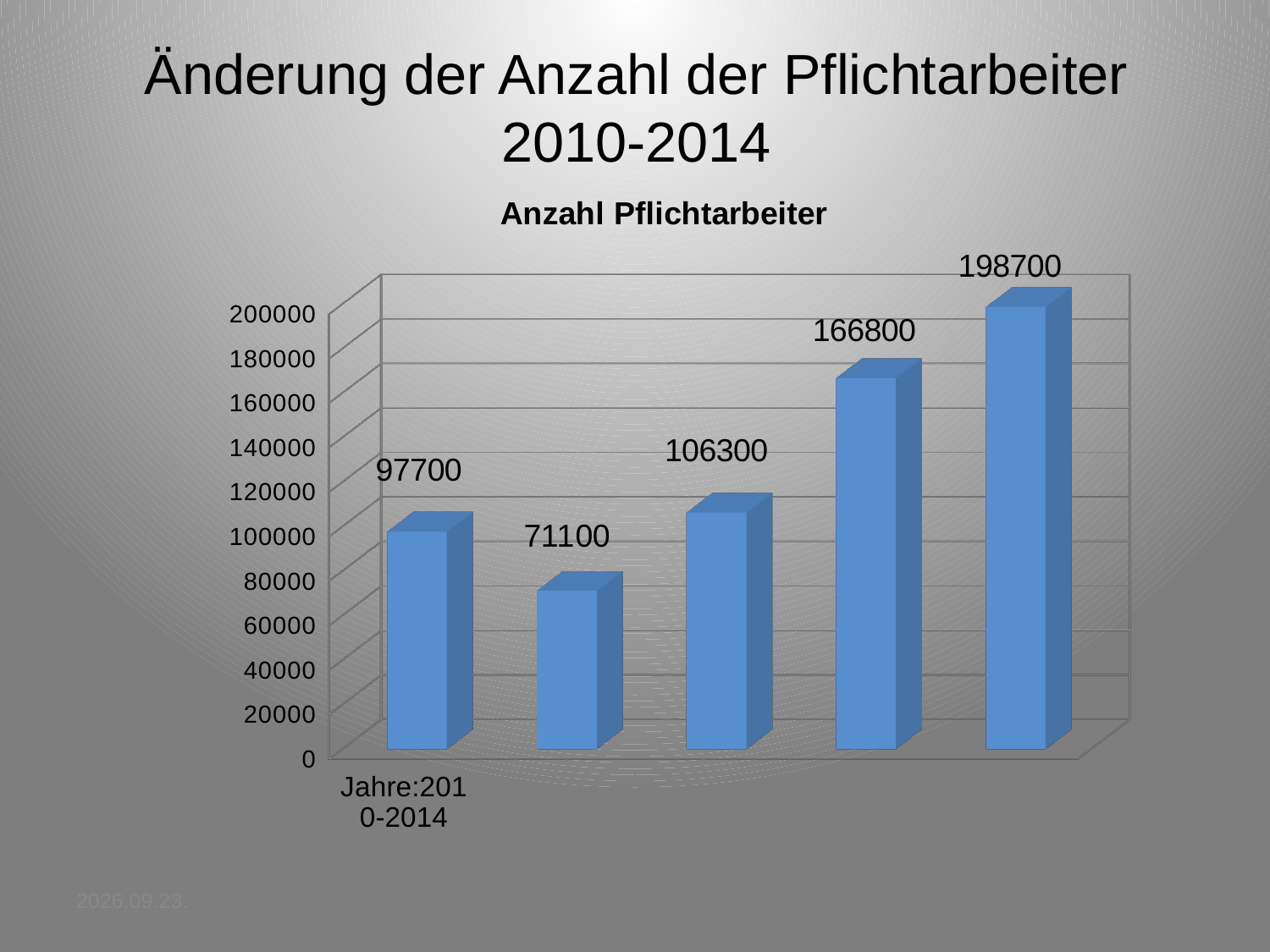
Which is larger, the first bar or the third bar? The third bar (106300) Which bar has the lowest value, and what is it? The second bar, 71100 What is the value of the first (leftmost) bar in the chart? 97700 What is the value of the second bar from the left? 71100 How much larger is the first bar (97700) than the second bar (71100)? 26600 What is the difference between the fifth bar (198700) and the fourth bar (166800)? 31900 What is the value of the third bar from the left? 106300 What is the title of the chart? Anzahl Pflichtarbeiter Which bar has the highest value, and what is it? The fifth (rightmost) bar, 198700 What type of chart is shown on the slide? Bar chart How many bars are plotted in the chart? 5 What is the value of the fourth bar from the left? 166800